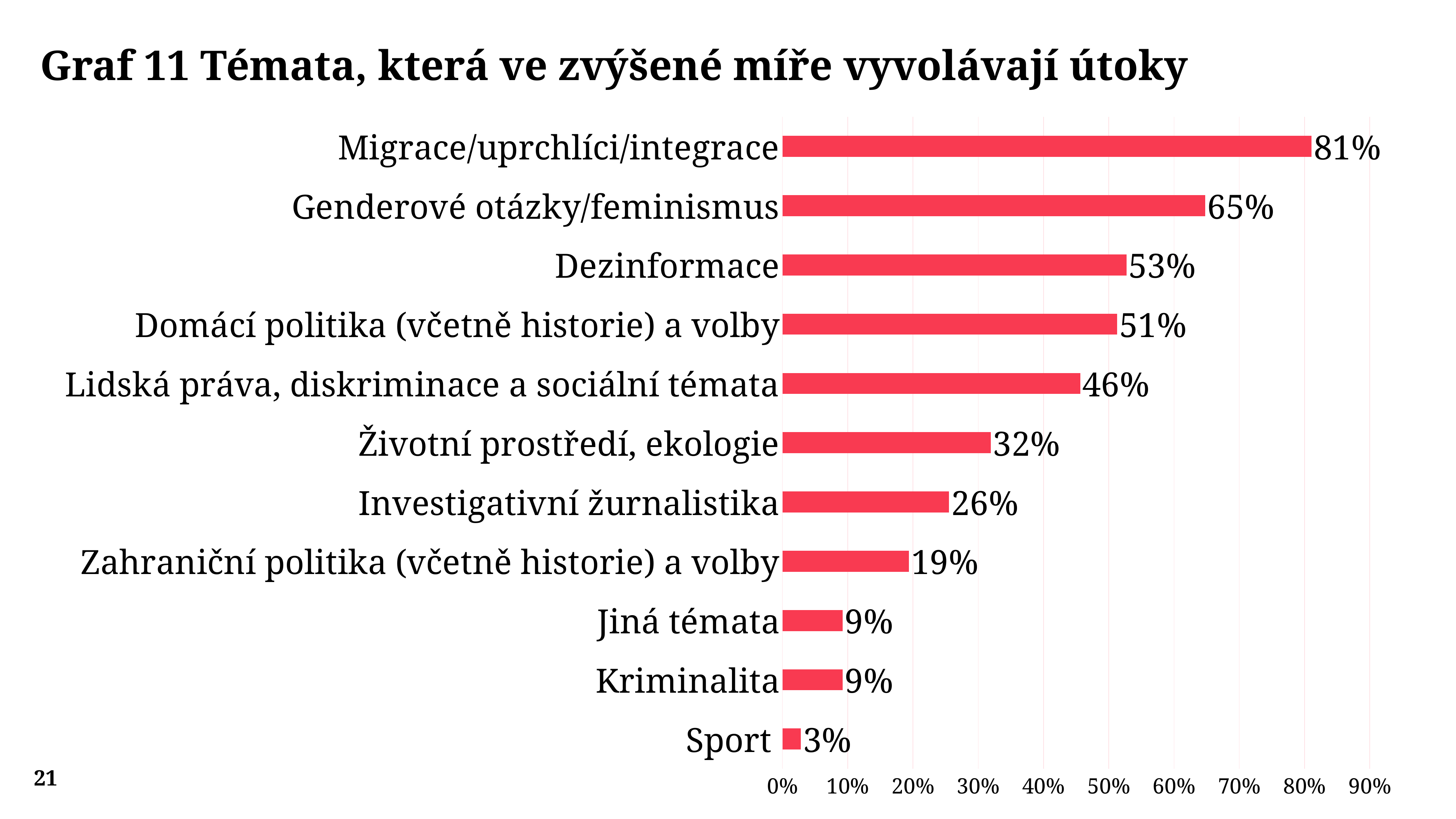
What is the title of the chart? Graf 11 Témata, která ve zvýšené míře vyvolávají útoky What kind of chart is shown on the slide? bar chart Which category has the highest value? Migrace/uprchlíci/integrace Which is larger, the value for Investigativní žurnalistika or the value for Zahraniční politika (včetně historie) a volby? Investigativní žurnalistika What is the value for Dezinformace? 53% What is the value for Migrace/uprchlíci/integrace? 81% What is the difference between the values for Migrace/uprchlíci/integrace and Sport? 78% Which category has the lowest value? Sport What is the difference between the values for Genderové otázky/feminismus and Dezinformace? 12% How many categories are shown in the chart? 11 What is the value for Životní prostředí, ekologie? 32% Is the value for Lidská práva, diskriminace a sociální témata greater or less than 40%? greater